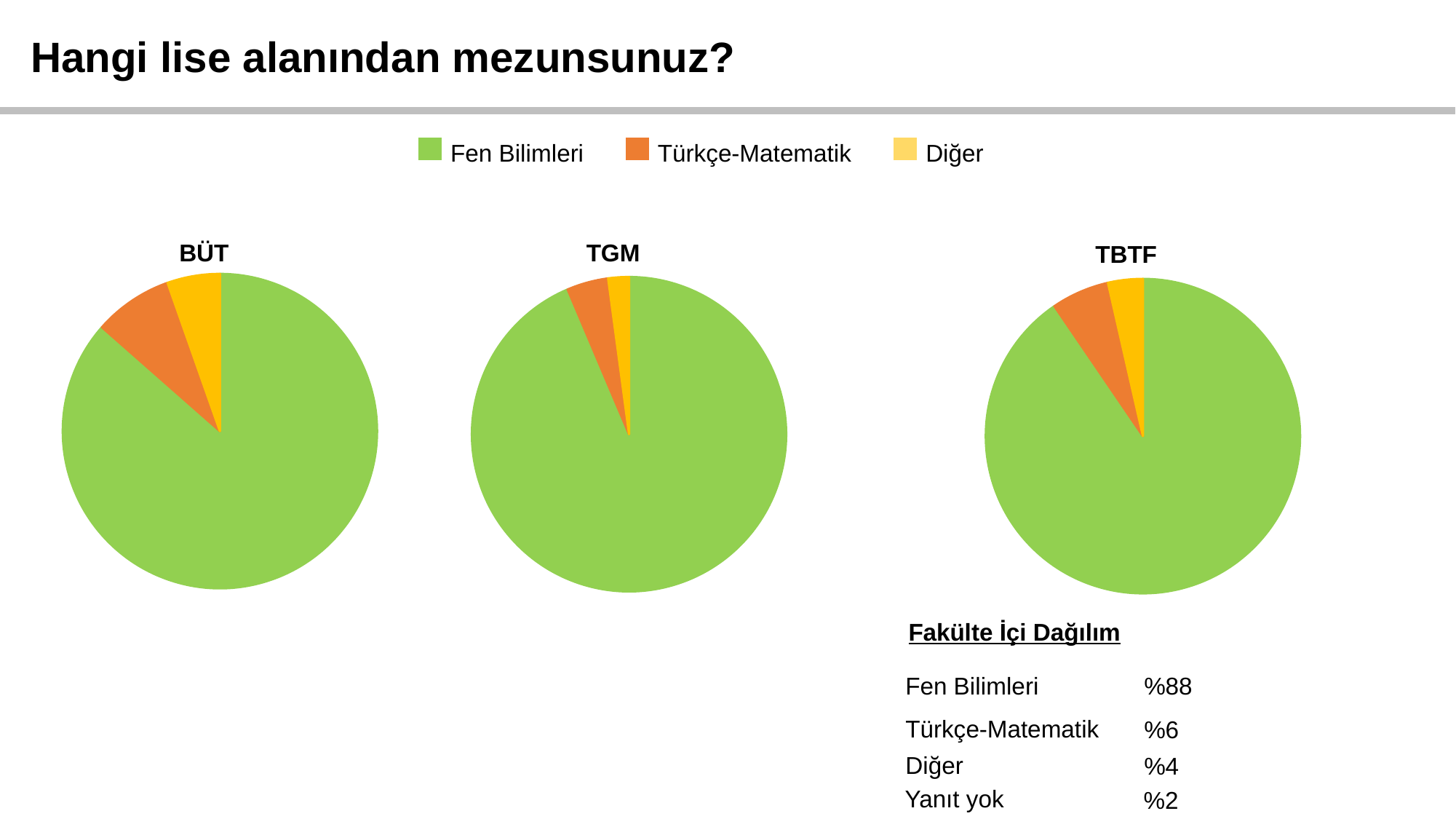
In the TBTF pie chart, which category has the largest slice? Fen Bilimleri How many series does the legend list for the pie charts? 3 What kind of chart is the BÜT chart? pie chart What colour represents Fen Bilimleri in the pie charts? green How many slices does the TGM pie chart have? 3 In the BÜT pie chart, which category has the smallest slice? Diğer In the TGM pie chart, which category has the largest slice? Fen Bilimleri In the BÜT pie chart, which slice is larger: Türkçe-Matematik or Diğer? Türkçe-Matematik In the TBTF pie chart, which category has the smallest slice? Diğer What is the title of the TBTF pie chart? TBTF In the TGM pie chart, which slice is larger: Fen Bilimleri or Türkçe-Matematik? Fen Bilimleri In the BÜT pie chart, which category has the largest slice? Fen Bilimleri